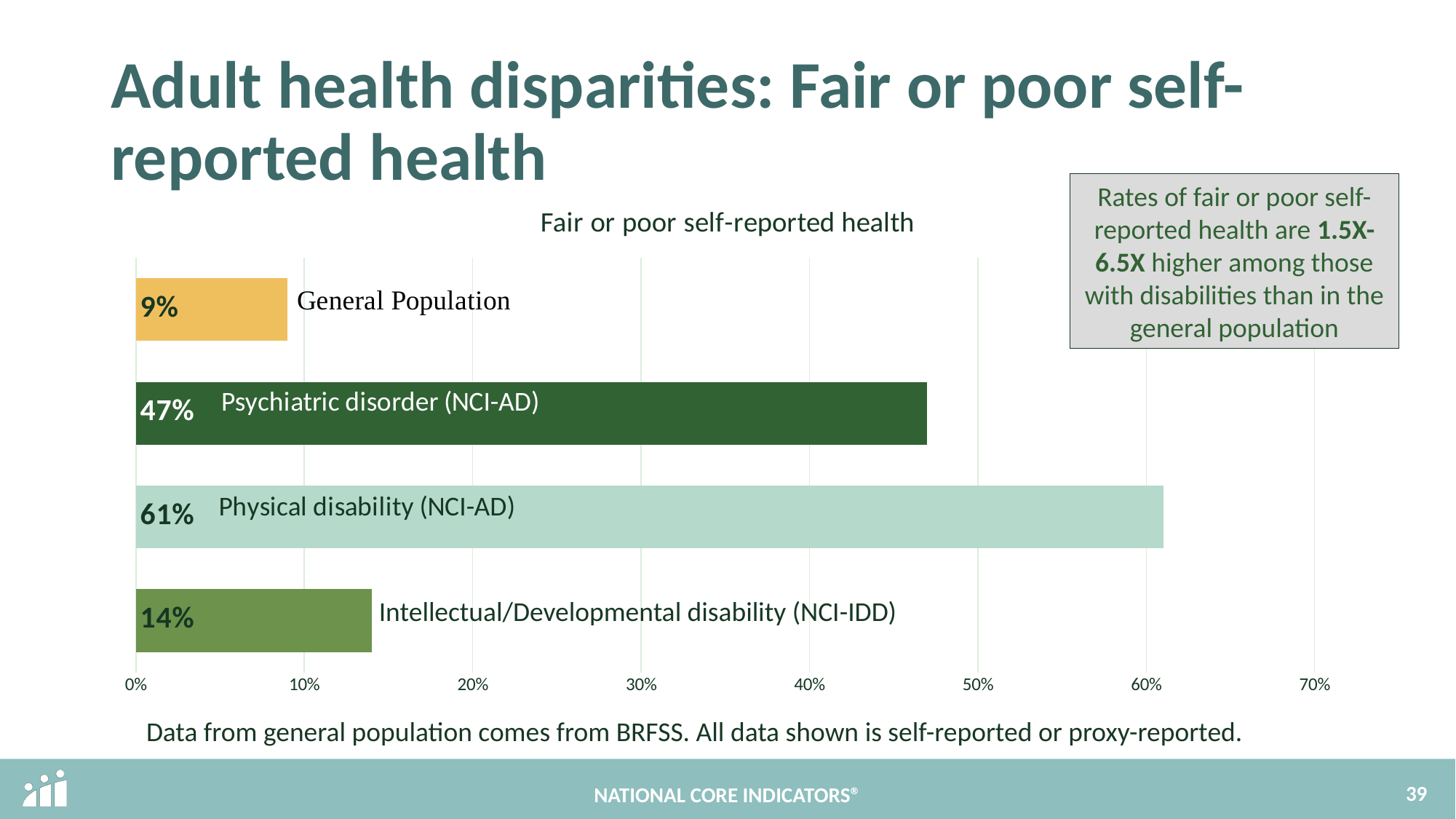
Which category has the lowest rate of fair or poor self-reported health? General Population What is the value for Psychiatric disorder (NCI-AD)? 47% What is the difference between the values for Intellectual/Developmental disability (NCI-IDD) and General Population? 5% What is the value for Physical disability (NCI-AD)? 61% What is the value for General Population? 9% What is the title of the chart? Fair or poor self-reported health Which category has the highest rate of fair or poor self-reported health? Physical disability (NCI-AD) What is the value for Intellectual/Developmental disability (NCI-IDD)? 14% What is the difference between the values for Physical disability (NCI-AD) and Psychiatric disorder (NCI-AD)? 14% What kind of chart is shown on the slide? Bar chart Which is larger, the value for Psychiatric disorder (NCI-AD) or Intellectual/Developmental disability (NCI-IDD)? Psychiatric disorder (NCI-AD) How many categories are shown in the chart? 4